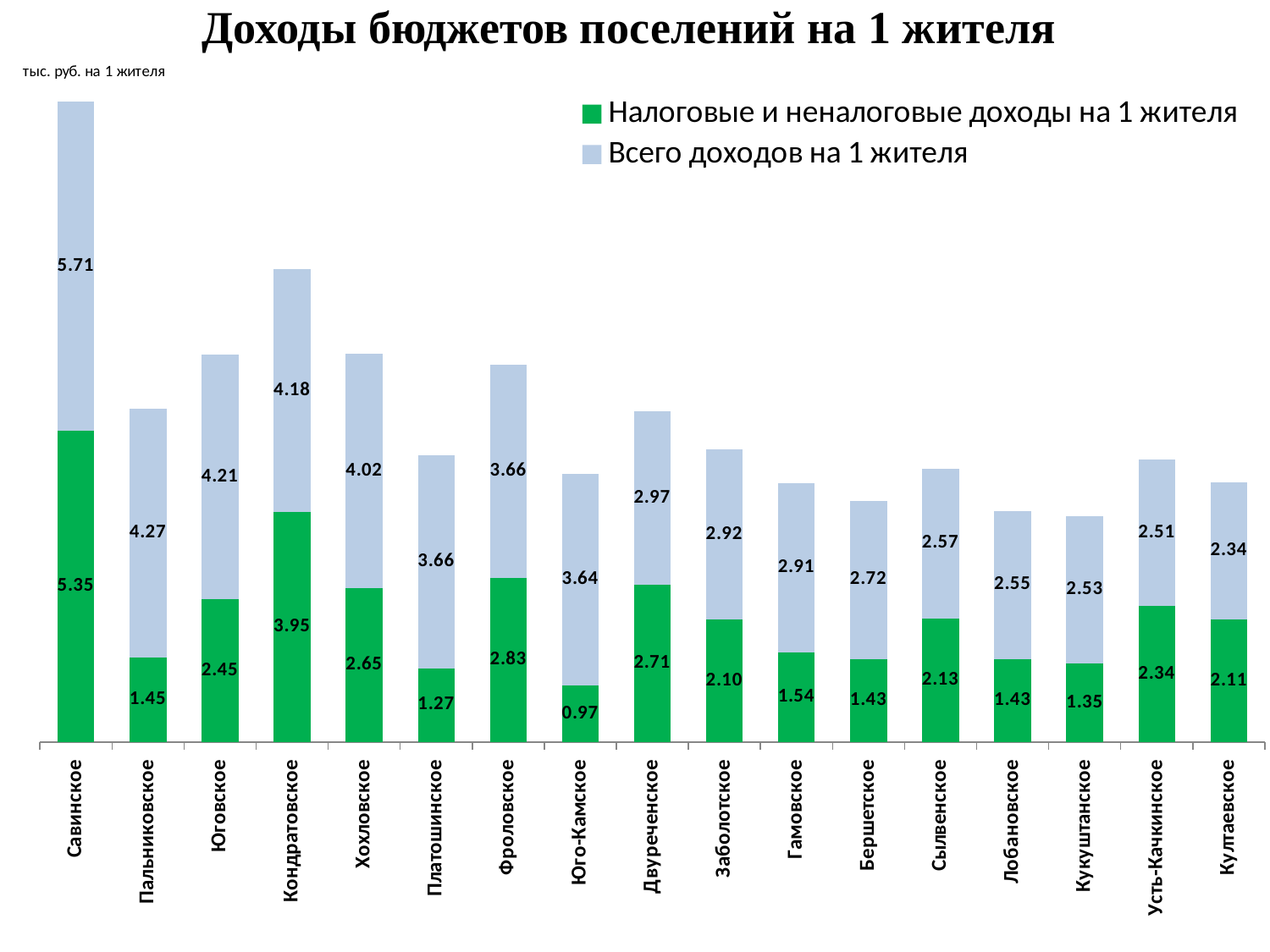
How many series does the legend list? 2 How many settlements are shown on the x axis? 17 What is the value of 'Налоговые и неналоговые доходы на 1 жителя' for Юго-Камское? 0.97 What is the value of 'Всего доходов на 1 жителя' for Култаевское? 2.34 Which has the larger 'Налоговые и неналоговые доходы на 1 жителя' value, Юговское or Хохловское? Хохловское What is the value of 'Всего доходов на 1 жителя' for Кондратовское? 4.18 Which settlement has the highest value of 'Налоговые и неналоговые доходы на 1 жителя'? Савинское What is the difference between the 'Налоговые и неналоговые доходы на 1 жителя' values for Савинское and Пальниковское? 3.90 Which settlement has the highest value of 'Всего доходов на 1 жителя'? Савинское Which settlement has the lowest value of 'Налоговые и неналоговые доходы на 1 жителя'? Юго-Камское What type of chart is shown on the slide? Stacked bar chart What is the value of 'Налоговые и неналоговые доходы на 1 жителя' for Савинское? 5.35